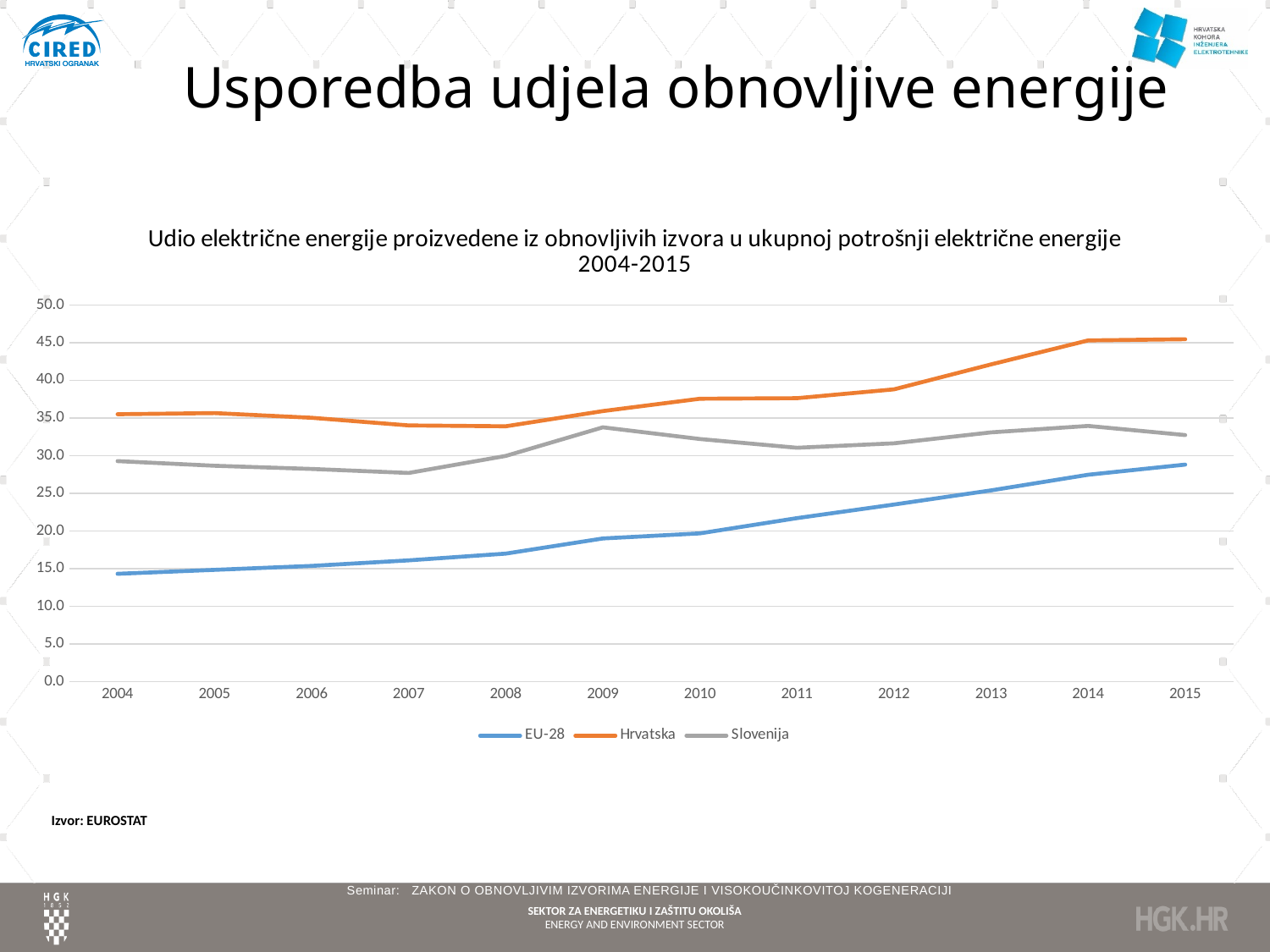
What kind of chart is shown on the slide? line chart Which series has the highest value in 2015? Hrvatska Does the EU-28 line rise or fall from 2004 to 2015? rise Which series has the lowest value in 2004? EU-28 How many series does the legend list? 3 Is the value for Hrvatska in 2015 greater or less than 40.0? greater How many years are plotted along the x axis? 12 In 2009, which is larger: the value for Hrvatska or the value for Slovenija? Hrvatska Which series is drawn in orange? Hrvatska In 2015, which is larger: the value for EU-28 or the value for Slovenija? Slovenija Is the value for EU-28 in 2012 greater or less than 20.0? greater Is the value for Slovenija in 2007 greater or less than 30.0? less